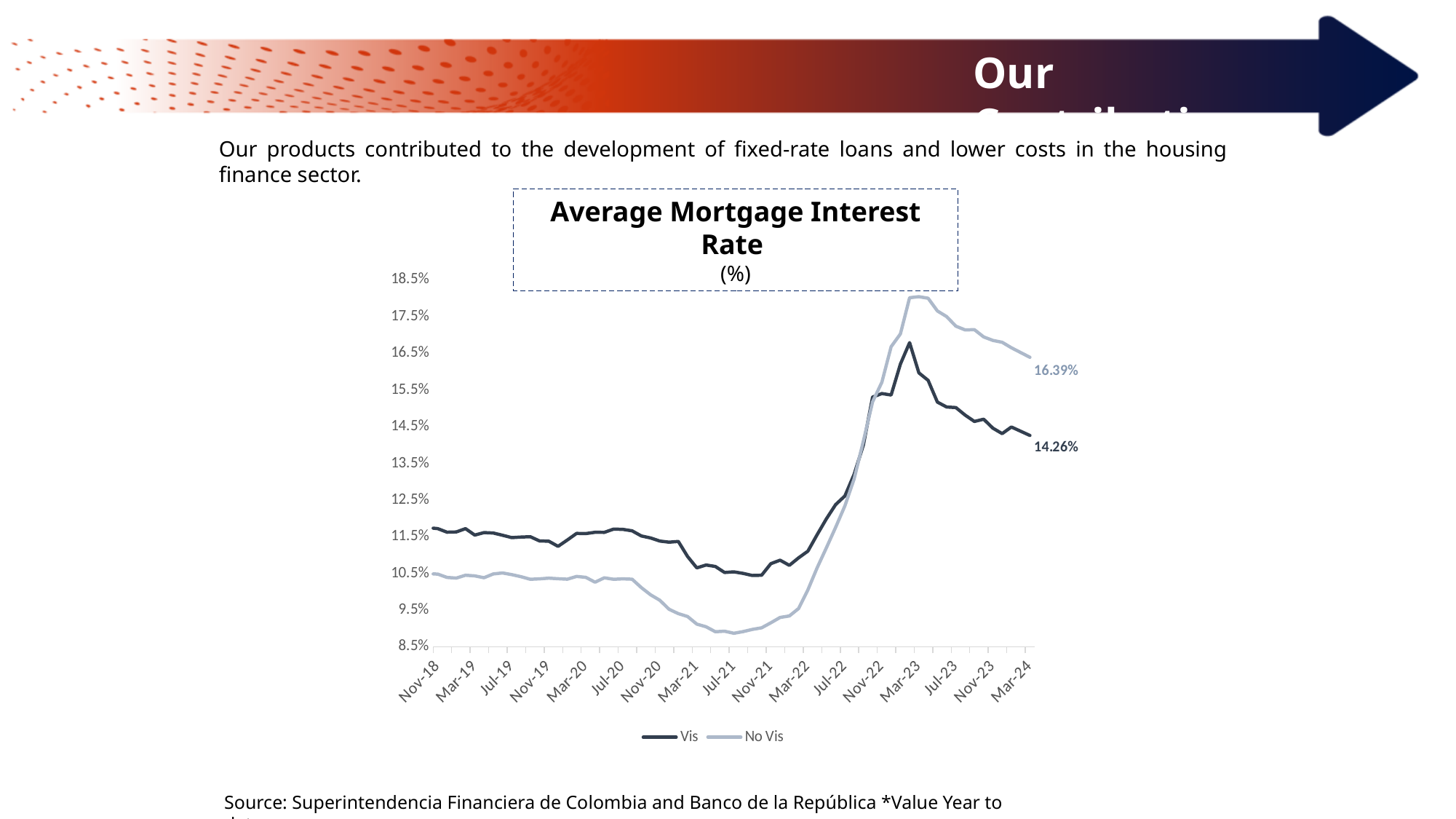
At Mar-24, which series has the higher value, Vis or No Vis? No Vis Is the No Vis value at Jul-21 greater or less than 9.5%? less What is the value of the Vis series at Mar-24 in the Average Mortgage Interest Rate chart? 14.26% How many series does the legend list? 2 What is the title of the chart? Average Mortgage Interest Rate (%) Is the Vis value at Jul-21 greater or less than 11.5%? less Do the Vis and No Vis values rise or fall between Mar-23 and Mar-24? Fall Which series reaches the highest peak in the chart? No Vis What kind of chart is shown on the slide? Line chart What is the difference between the No Vis and Vis values at Mar-24? 2.13 percentage points Is the No Vis value at Nov-18 greater or less than 11.5%? less What is the value of the No Vis series at Mar-24 in the Average Mortgage Interest Rate chart? 16.39%